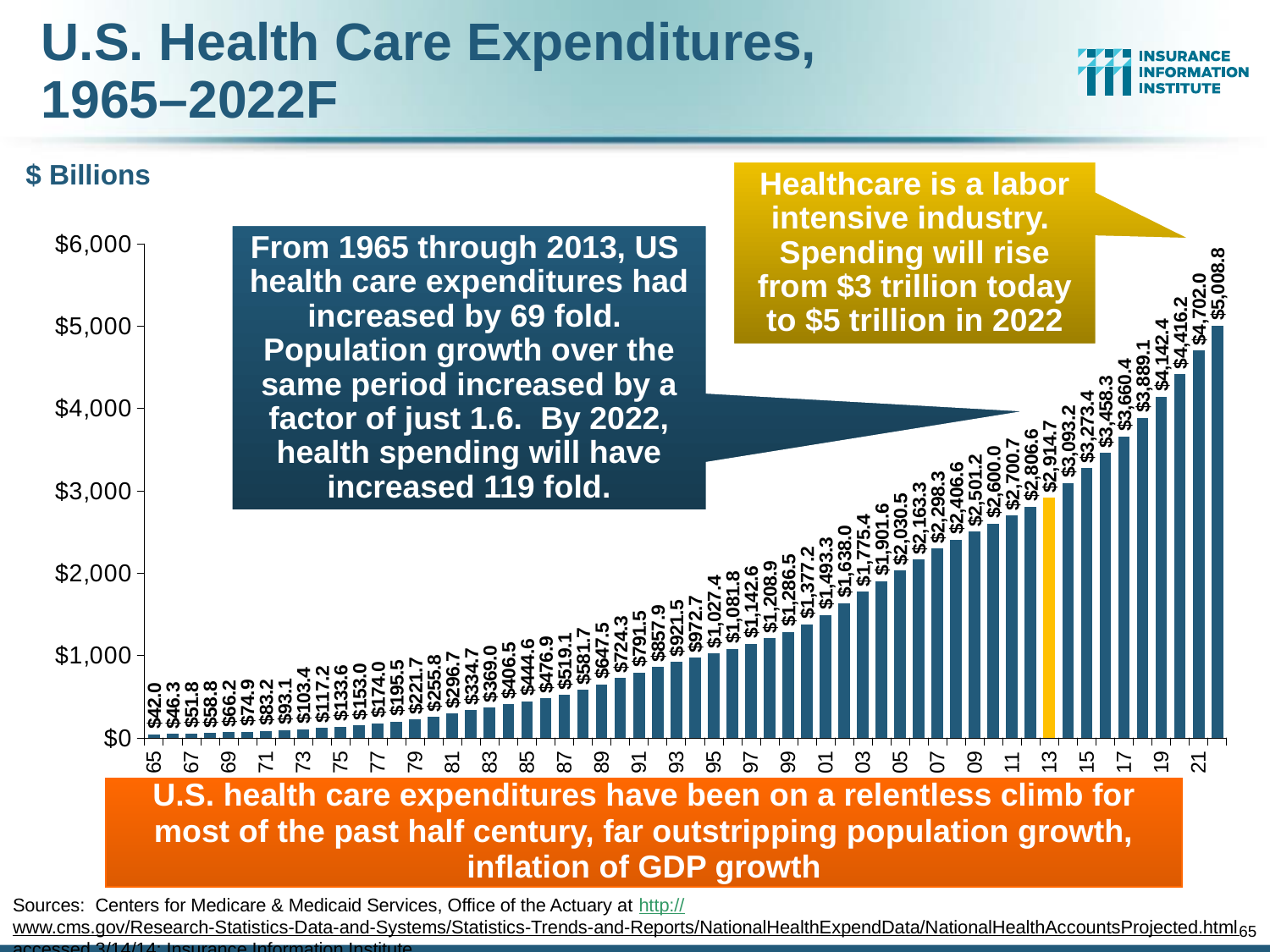
What was U.S. health care expenditure in 1965? $42.0 What is the difference between the 2022F value and the 2013 value? $2,094.1 What is the value of the highlighted (yellow) bar for 2013? $2,914.7 Is the value for 2013 greater or less than $3,000? less How many bars (years) are plotted on the chart? 58 What type of chart is shown on the slide? Bar chart What is the forecast U.S. health care expenditure for 2022? $5,008.8 Which year has the highest U.S. health care expenditure on the chart? 2022F Do U.S. health care expenditures rise or fall from 1965 to 2022F? Rise In what unit are the values on the y-axis expressed? $ Billions Which is larger, the value for 2021 or the value for 2013? 2021 Which year has the lowest U.S. health care expenditure on the chart? 1965